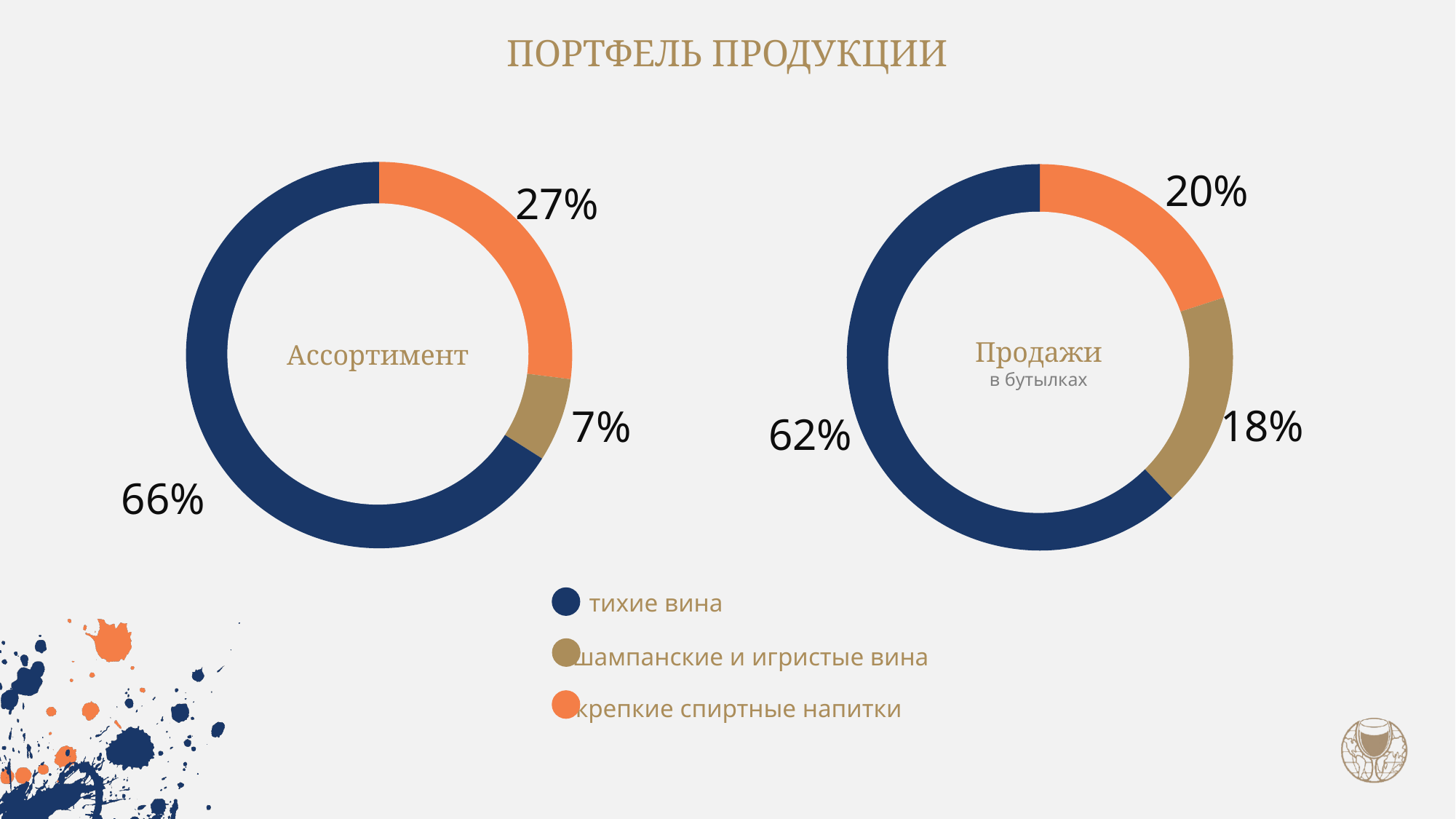
In the "Продажи в бутылках" chart, which category has the largest share? тихие вина In the "Ассортимент" chart, what share is shown for крепкие спиртные напитки? 27% What type of chart is the "Продажи в бутылках" chart? Donut (pie) chart In the "Ассортимент" chart, which category has the smallest share? шампанские и игристые вина In the "Продажи в бутылках" chart, what share is shown for тихие вина? 62% In the "Ассортимент" chart, what share is shown for шампанские и игристые вина? 7% In the "Продажи в бутылках" chart, what share is shown for крепкие спиртные напитки? 20% In the "Ассортимент" chart, what is the difference between the shares of крепкие спиртные напитки and шампанские и игристые вина? 20% Which is larger: the share of тихие вина in the "Ассортимент" chart or in the "Продажи в бутылках" chart? Ассортимент How many categories does the legend list for the charts? 3 In the "Продажи в бутылках" chart, what share is shown for шампанские и игристые вина? 18% In the "Ассортимент" chart, what share is shown for тихие вина? 66%